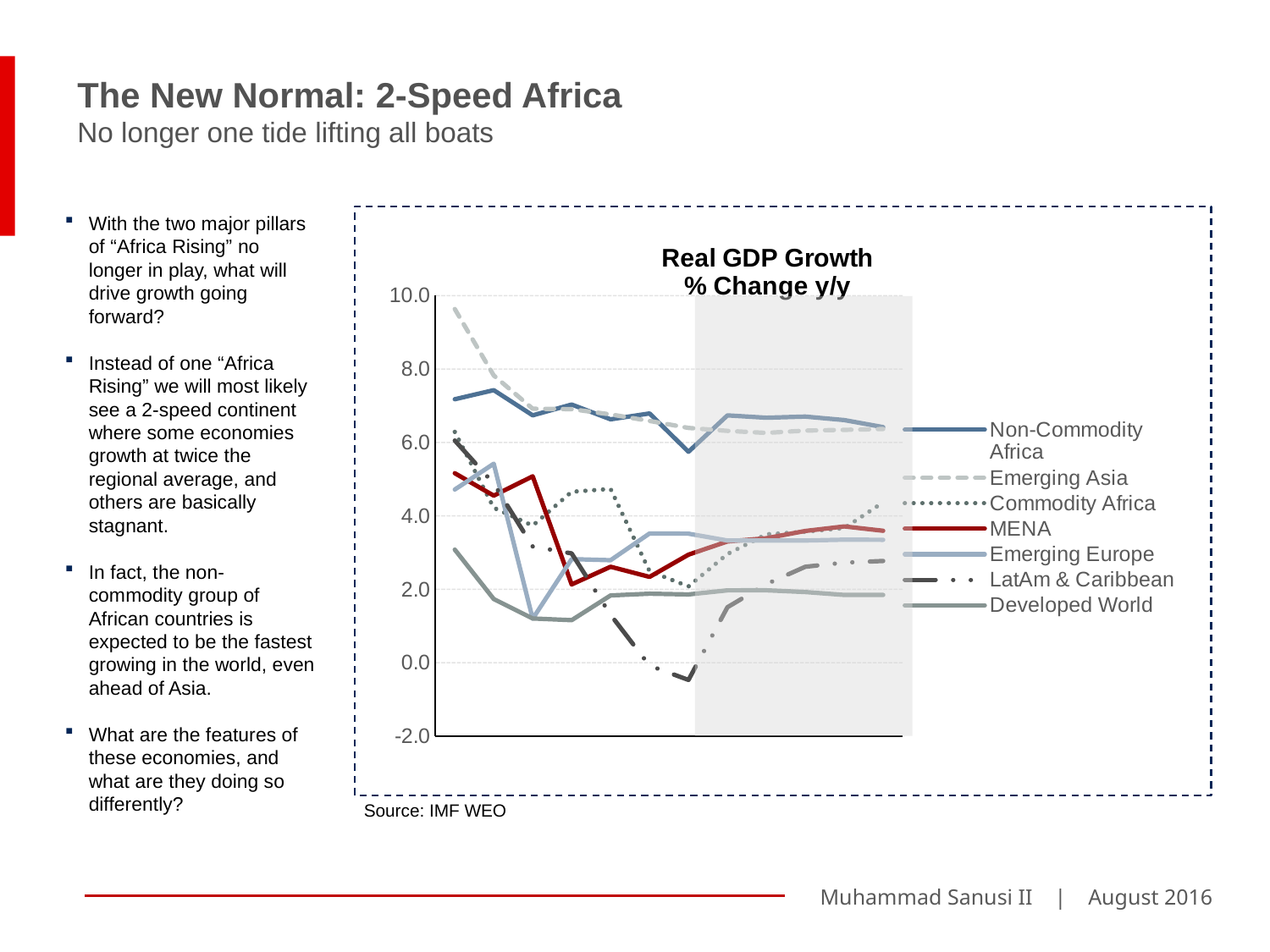
Is the starting value of the Developed World series greater or less than 4.0? less What kind of chart is shown on the slide? Line chart Is the highest value of the Non-Commodity Africa series greater or less than 8.0? less Does the Emerging Asia series generally rise or fall from left to right across the chart? fall What is the title of the chart? Real GDP Growth % Change y/y Which series reaches the lowest point anywhere on the chart? LatAm & Caribbean Is the starting value of the Emerging Asia series greater or less than 8.0? greater How many series does the legend of the Real GDP Growth chart list? 7 Which series in the Real GDP Growth chart is drawn in red? MENA At the left-hand start of the chart, which is larger: Emerging Asia or Non-Commodity Africa? Emerging Asia Which series has the highest value at the left-hand start of the chart? Emerging Asia